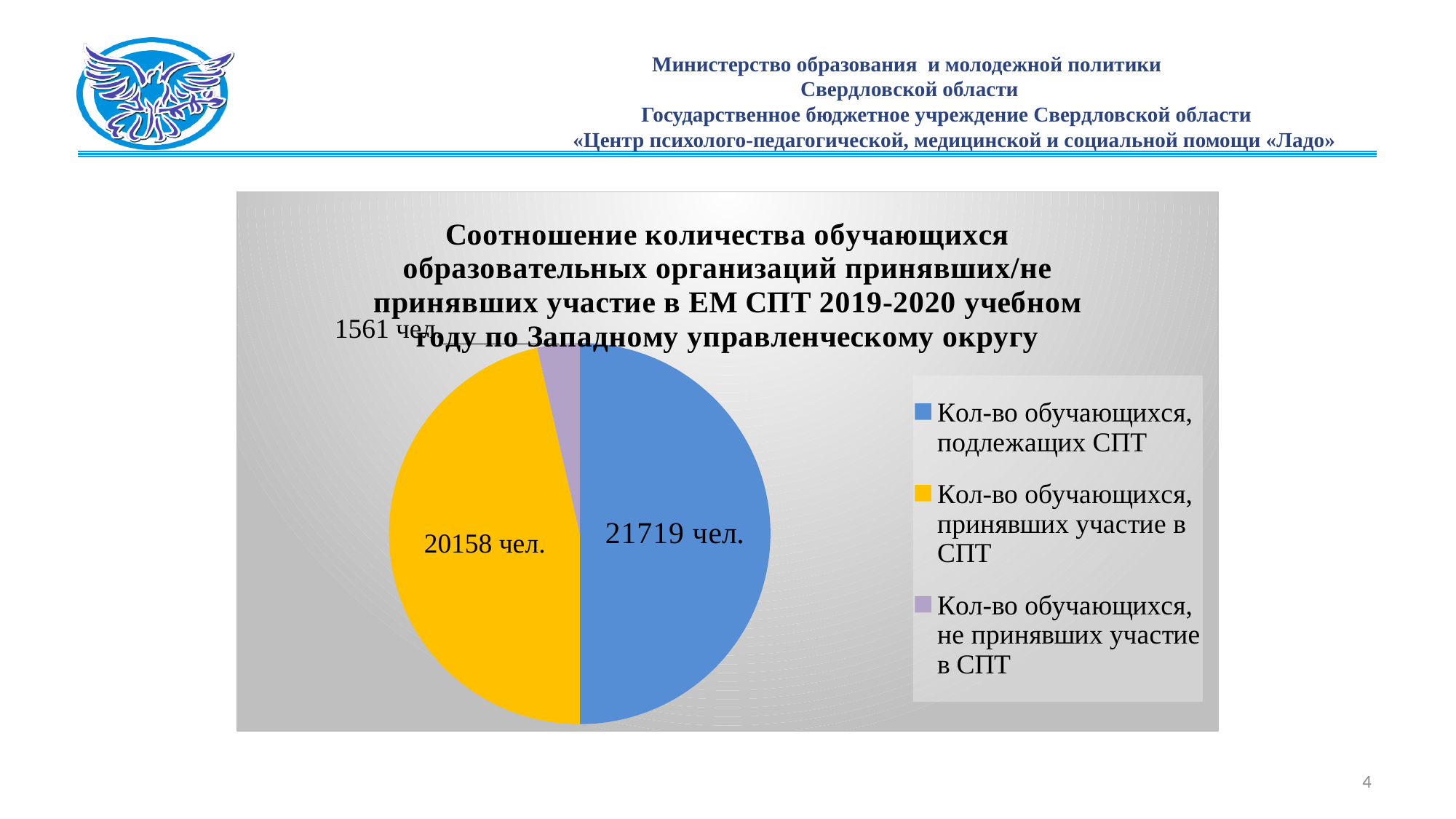
What share of the pie does the slice for "Кол-во обучающихся, подлежащих СПТ" represent? 50% Which category has the smallest slice of the pie? Кол-во обучающихся, не принявших участие в СПТ How many slices does the pie chart have? 3 What is the value shown for "Кол-во обучающихся, принявших участие в СПТ"? 20158 чел. Which is larger: the value for "Кол-во обучающихся, принявших участие в СПТ" or the value for "Кол-во обучающихся, не принявших участие в СПТ"? Кол-во обучающихся, принявших участие в СПТ What colour is the slice for "Кол-во обучающихся, не принявших участие в СПТ"? Purple What is the value shown for "Кол-во обучающихся, подлежащих СПТ"? 21719 чел. How many entries does the legend of the pie chart list? 3 What kind of chart is shown on the slide? Pie chart Which category has the largest slice of the pie? Кол-во обучающихся, подлежащих СПТ What is the difference between the value for "Кол-во обучающихся, подлежащих СПТ" and the value for "Кол-во обучающихся, принявших участие в СПТ"? 1561 чел. What is the value shown for "Кол-во обучающихся, не принявших участие в СПТ"? 1561 чел.